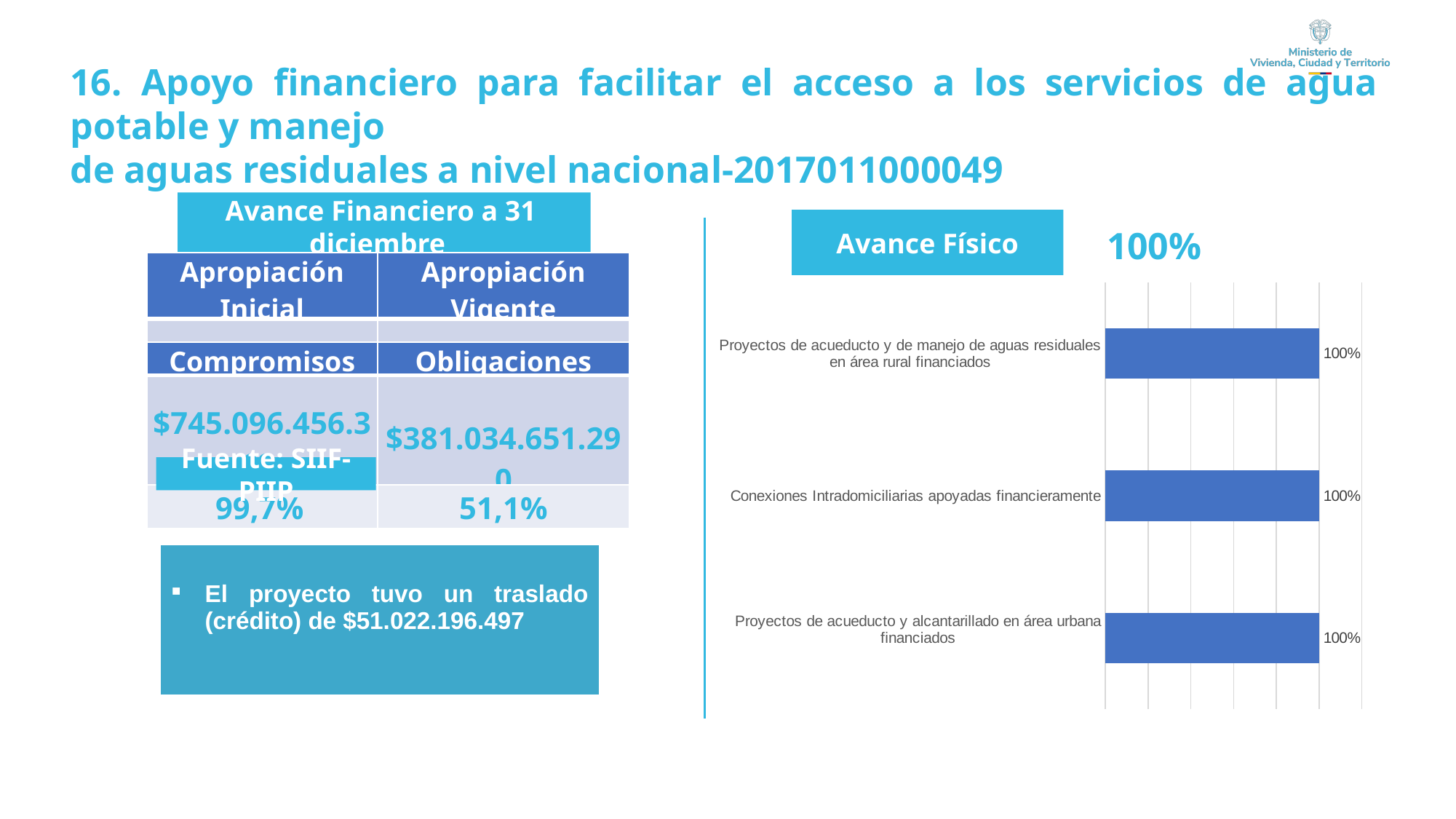
What is the value for "Proyectos de acueducto y de manejo de aguas residuales en área rural financiados" in the "Avance Físico" chart? 100% Which category is listed at the top of the "Avance Físico" bar chart? Proyectos de acueducto y de manejo de aguas residuales en área rural financiados What type of chart is shown under the heading "Avance Físico"? bar chart In the "Avance Físico" chart, what is the difference between the value for "Conexiones Intradomiciliarias apoyadas financieramente" and the value for "Proyectos de acueducto y alcantarillado en área urbana financiados"? 0% Do all three bars in the "Avance Físico" chart have the same value? Yes What is the value for "Conexiones Intradomiciliarias apoyadas financieramente" in the "Avance Físico" chart? 100% How many categories does the "Avance Físico" bar chart show? 3 What colour are the bars in the "Avance Físico" chart? blue Are the bars in the "Avance Físico" chart horizontal or vertical? horizontal What is the value for "Proyectos de acueducto y alcantarillado en área urbana financiados" in the "Avance Físico" chart? 100%